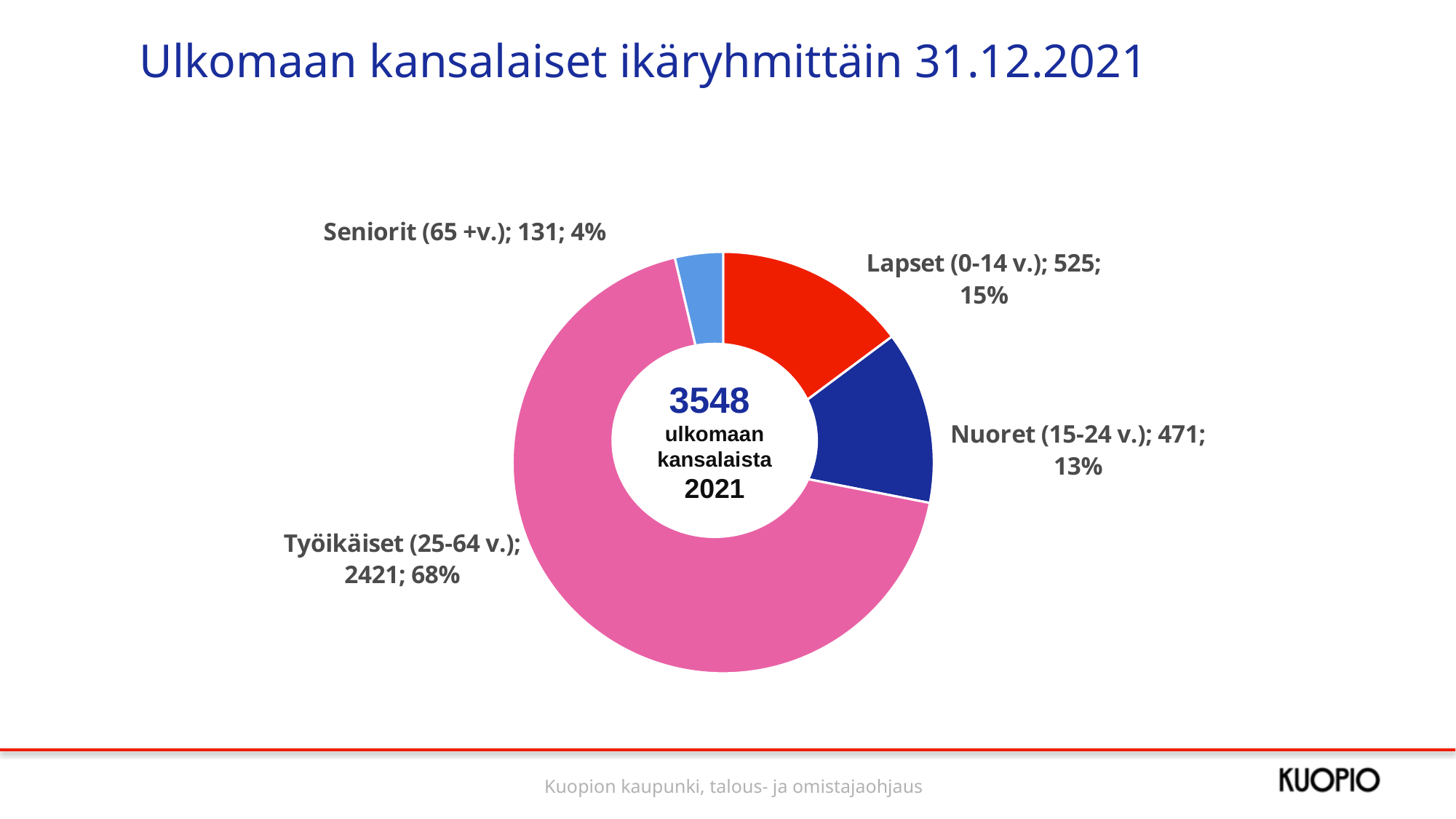
What is the value for Työikäiset (25-64 v.)? 2421 What share of the pie does Nuoret (15-24 v.) represent? 13% Which age group has the smallest slice? Seniorit (65 +v.) What is the title of the slide? Ulkomaan kansalaiset ikäryhmittäin 31.12.2021 Which age group has the largest slice? Työikäiset (25-64 v.) What is the difference between the Lapset (0-14 v.) and Nuoret (15-24 v.) values? 54 What total number is shown in the centre of the doughnut? 3548 How many age groups are shown in the chart? 4 How many foreign citizens are in the Lapset (0-14 v.) group? 525 What percentage share does Seniorit (65 +v.) have? 4% Which is larger, the value for Lapset (0-14 v.) or Seniorit (65 +v.)? Lapset (0-14 v.) What kind of chart is shown on the slide? Pie chart (doughnut)